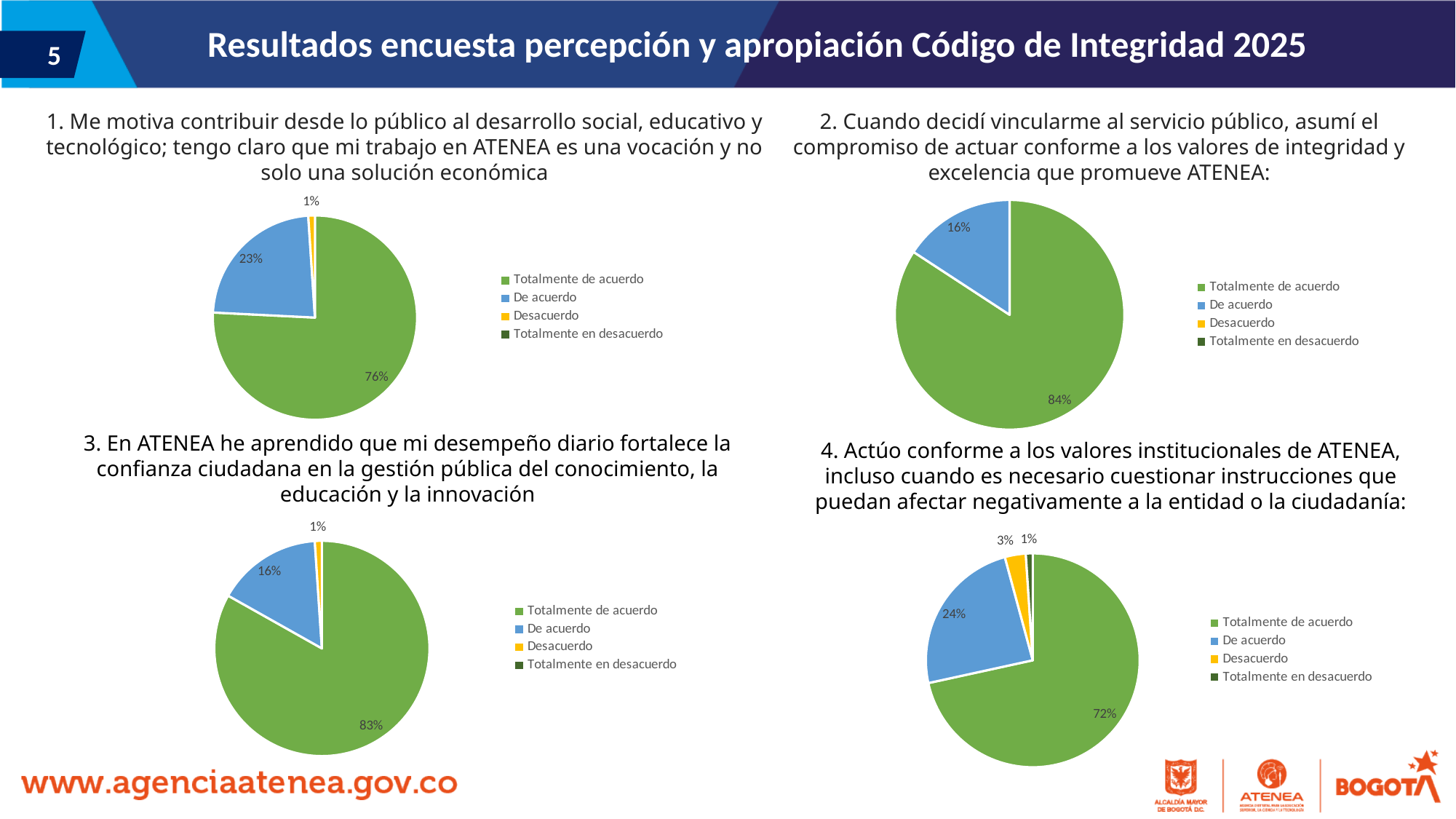
In the bottom-right pie chart (question 4), which category has the largest slice? Totalmente de acuerdo In the top-right pie chart (question 2), what share is labelled for 'De acuerdo'? 16% In the top-right pie chart (question 2), what share is labelled for 'Totalmente de acuerdo'? 84% In the top-left pie chart (question 1), what share is labelled for 'De acuerdo'? 23% In the top-left pie chart (question 1), what share is labelled for 'Totalmente de acuerdo'? 76% Which is larger: the 'Totalmente de acuerdo' share in the top-right chart (question 2) or in the bottom-right chart (question 4)? Top-right chart (question 2) How many entries does the legend of the top-left pie chart (question 1) list? 4 In the bottom-right pie chart (question 4), what share is labelled for 'Desacuerdo'? 3% In the bottom-right pie chart (question 4), what is the difference in percentage points between 'Totalmente de acuerdo' and 'De acuerdo'? 48 What type of chart is used for question 3 (bottom-left)? Pie chart In the bottom-right pie chart (question 4), which labelled category has the smallest slice? Totalmente en desacuerdo In the bottom-left pie chart (question 3), what share is labelled for 'Totalmente de acuerdo'? 83%